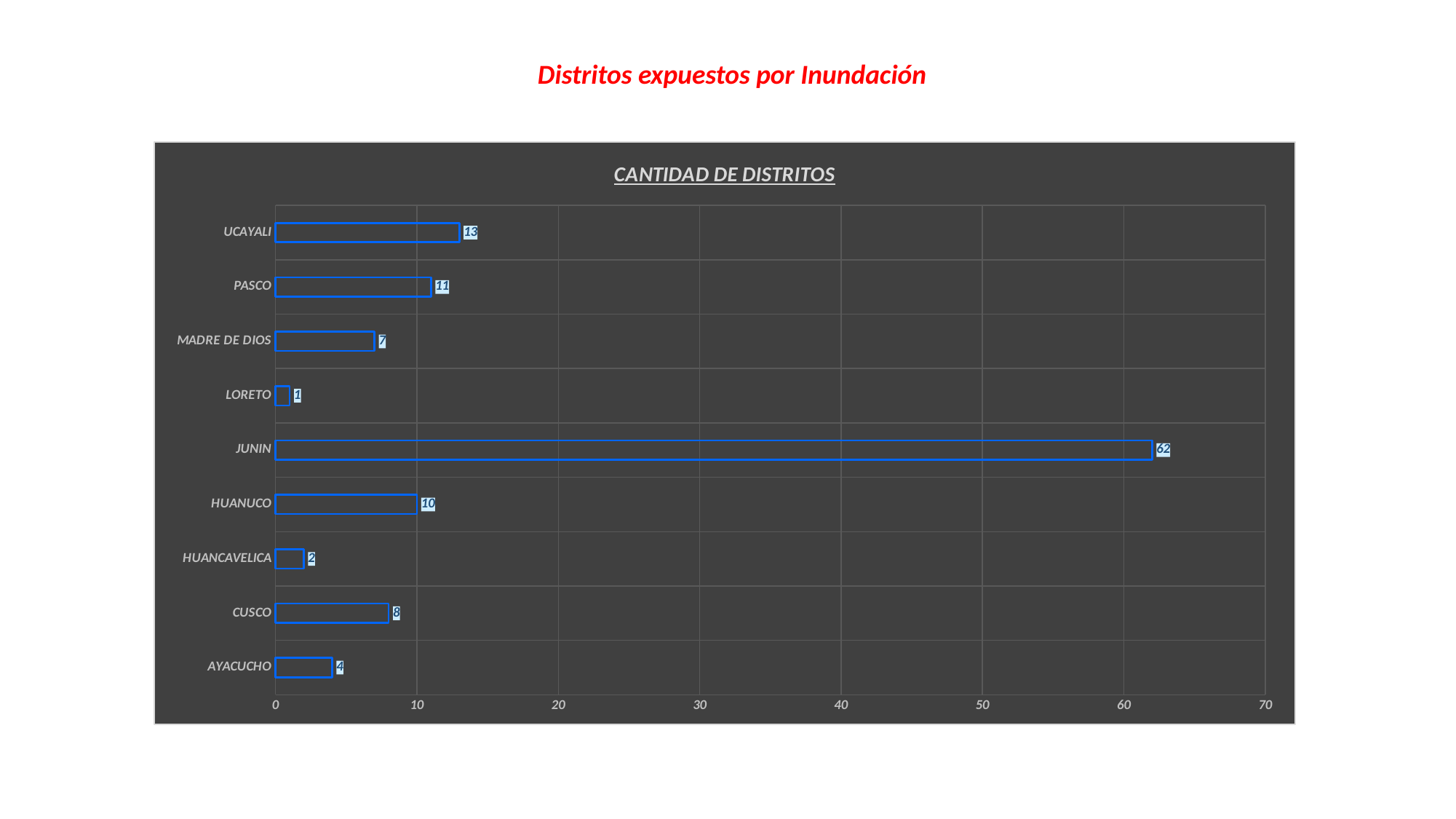
How many categories are shown in the chart? 9 Which category has the highest value? JUNIN What kind of chart is shown? bar chart Is the value for JUNIN greater or less than 60? greater What is the difference between the values for JUNIN and UCAYALI? 49 Which is larger, the value for CUSCO or the value for AYACUCHO? CUSCO What is the title of the chart? CANTIDAD DE DISTRITOS What is the difference between the values for PASCO and HUANUCO? 1 What is the value for MADRE DE DIOS? 7 What is the value for JUNIN? 62 Which category has the lowest value? LORETO What is the value for UCAYALI? 13